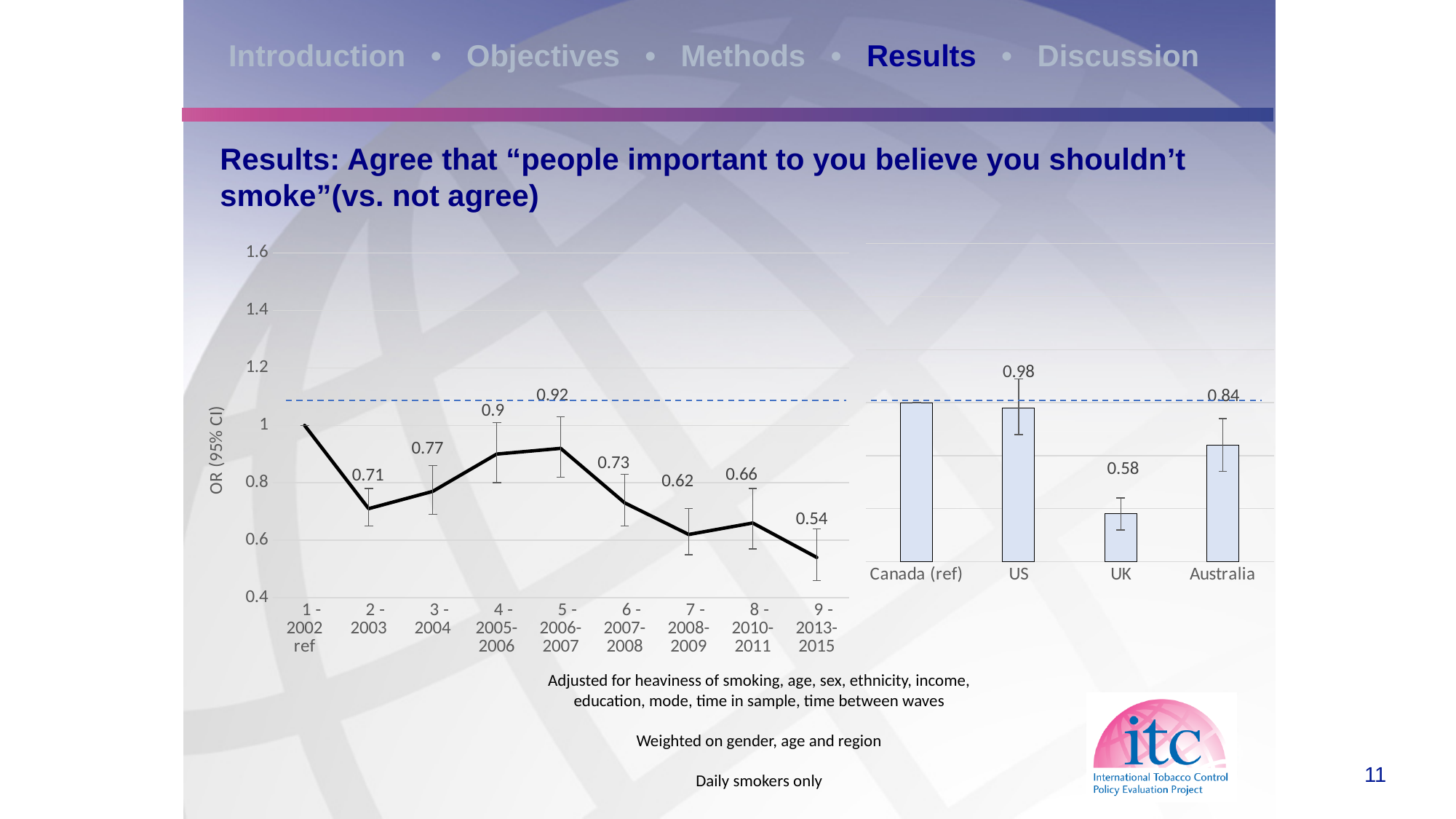
In the line chart on the left, what is the difference between the odds ratios for wave 5 (2006-2007) and wave 9 (2013-2015)? 0.38 In the bar chart on the right, which country has the lowest odds ratio? UK In the bar chart on the right, what is the odds ratio for the UK? 0.58 In the line chart on the left, is the odds ratio for wave 7 (2008-2009) greater or less than 0.8? less In the line chart on the left, what is the odds ratio for wave 9 (2013-2015)? 0.54 How many waves are plotted on the x axis of the line chart on the left? 9 In the line chart on the left, which wave after the reference wave has the lowest odds ratio? 9 - 2013-2015 In the bar chart on the right, which is larger, the odds ratio for the US or for Australia? US In the line chart on the left, what is the odds ratio for wave 5 (2006-2007)? 0.92 In the line chart on the left, what is the odds ratio for wave 2 (2003)? 0.71 In the bar chart on the right, what is the odds ratio for Australia? 0.84 What type of chart is shown on the right side of the slide? Bar chart